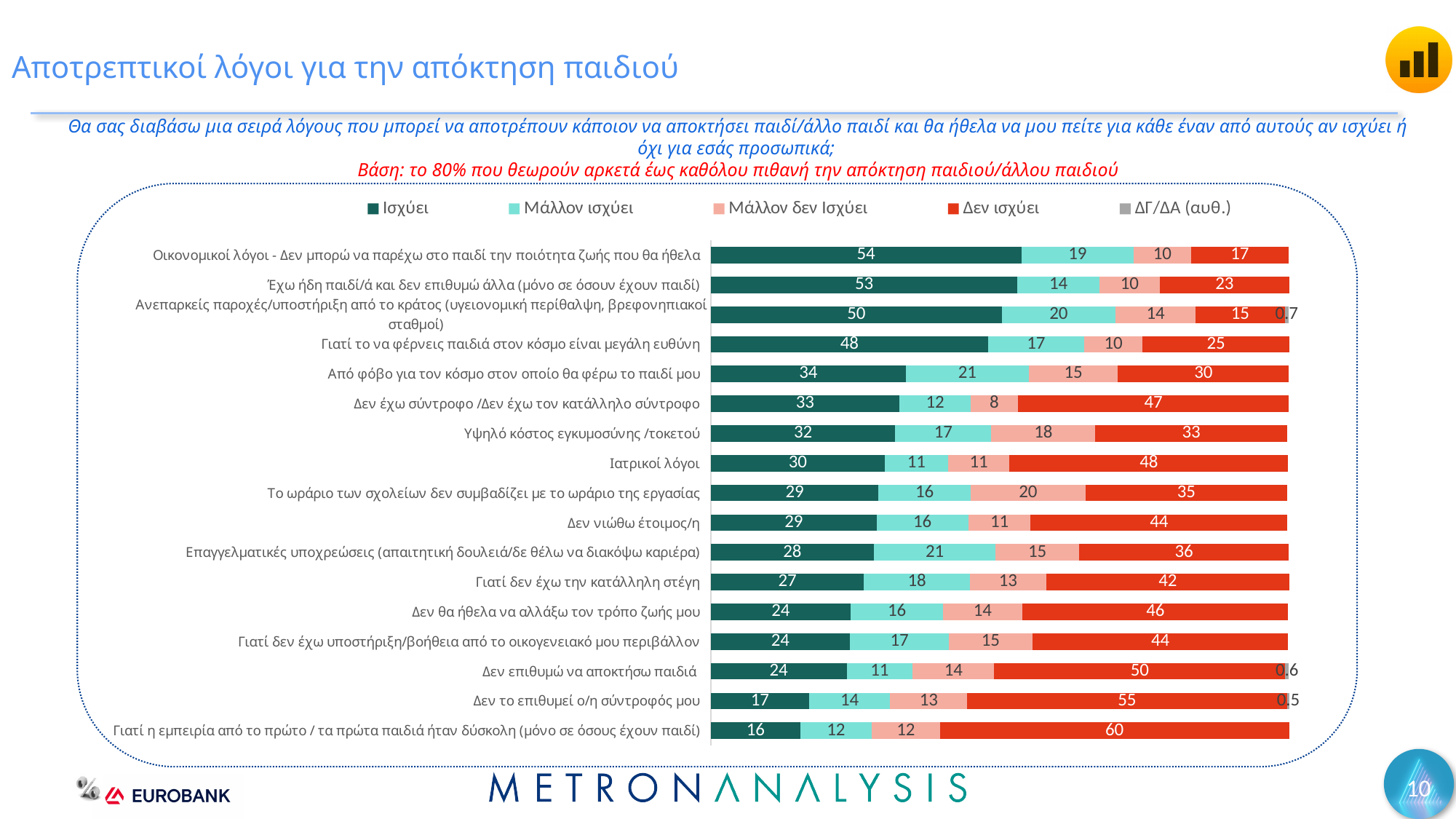
What type of chart is shown on the slide? Stacked bar chart Which reason has the highest 'Δεν ισχύει' value? Γιατί η εμπειρία από το πρώτο / τα πρώτα παιδιά ήταν δύσκολη (μόνο σε όσους έχουν παιδί) What is the 'ΔΓ/ΔΑ (αυθ.)' value for 'Δεν το επιθυμεί ο/η σύντροφός μου'? 0.5 What is the 'Μάλλον δεν Ισχύει' value for 'Το ωράριο των σχολείων δεν συμβαδίζει με το ωράριο της εργασίας'? 20 Which has a larger 'Δεν ισχύει' value: 'Δεν έχω σύντροφο /Δεν έχω τον κατάλληλο σύντροφο' or 'Από φόβο για τον κόσμο στον οποίο θα φέρω το παιδί μου'? Δεν έχω σύντροφο /Δεν έχω τον κατάλληλο σύντροφο How many reasons (categories) are plotted in the chart? 17 What is the 'Δεν ισχύει' value for 'Ιατρικοί λόγοι'? 48 Which reason has the highest 'Ισχύει' value? Οικονομικοί λόγοι - Δεν μπορώ να παρέχω στο παιδί την ποιότητα ζωής που θα ήθελα Which reason has the lowest 'Ισχύει' value? Γιατί η εμπειρία από το πρώτο / τα πρώτα παιδιά ήταν δύσκολη (μόνο σε όσους έχουν παιδί) What is the difference between the 'Ισχύει' values for 'Οικονομικοί λόγοι' and 'Γιατί η εμπειρία από το πρώτο / τα πρώτα παιδιά ήταν δύσκολη'? 38 What is the 'Ισχύει' value for 'Οικονομικοί λόγοι - Δεν μπορώ να παρέχω στο παιδί την ποιότητα ζωής που θα ήθελα'? 54 How many series does the legend list? 5